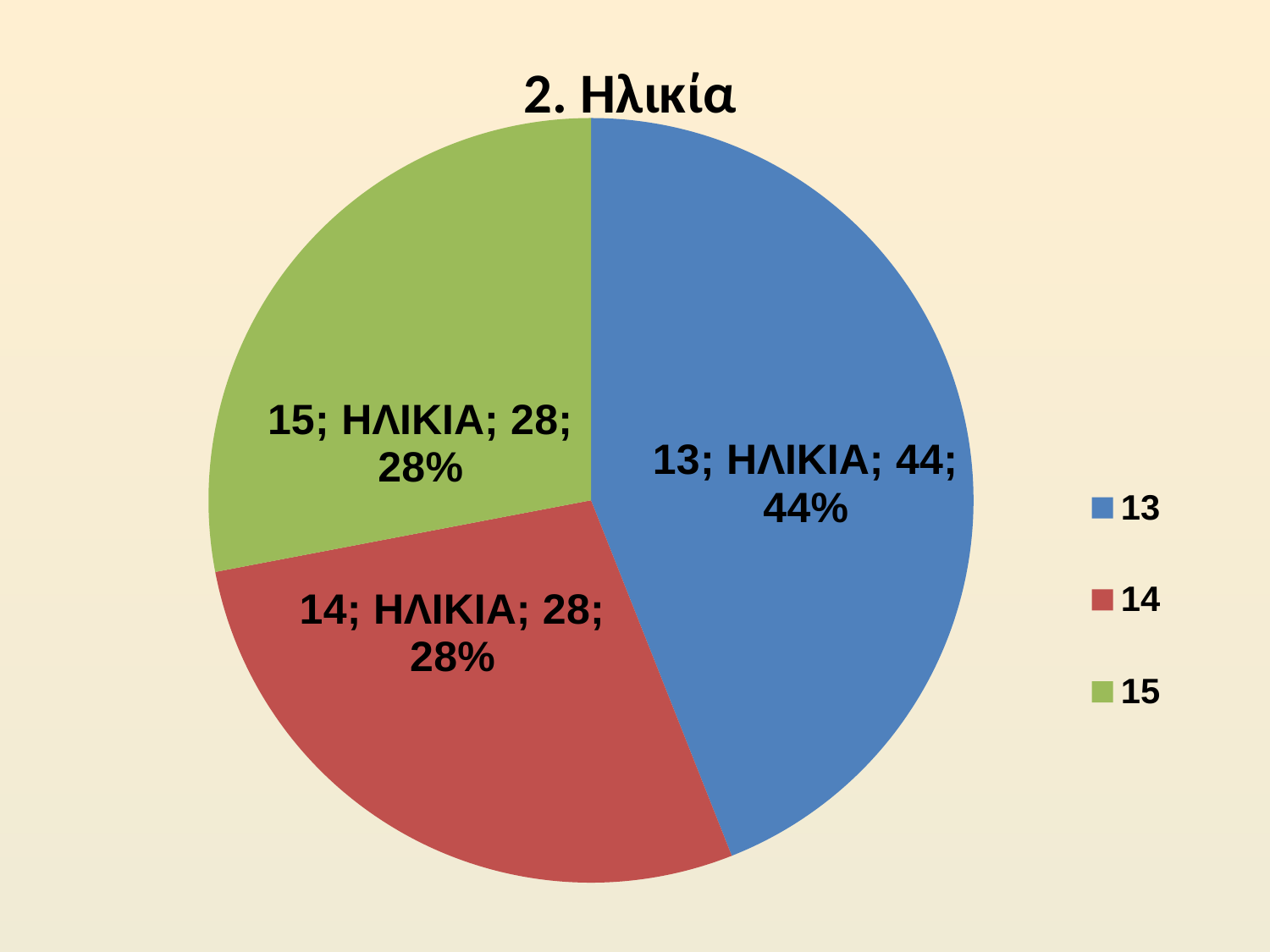
What is the title of the chart? 2. Ηλικία What value is shown for category 13? 44 What percentage share does category 15 have? 28% What kind of chart is shown on the slide? pie chart How many entries does the legend list? 3 What is the difference between the values for category 13 and category 14? 16 What value is shown for category 14? 28 What percentage share does category 13 have? 44% Which is larger, the value for category 13 or the value for category 15? 13 Which category has the largest slice? 13 What colour is the slice for category 14? red How many slices does the pie chart have? 3